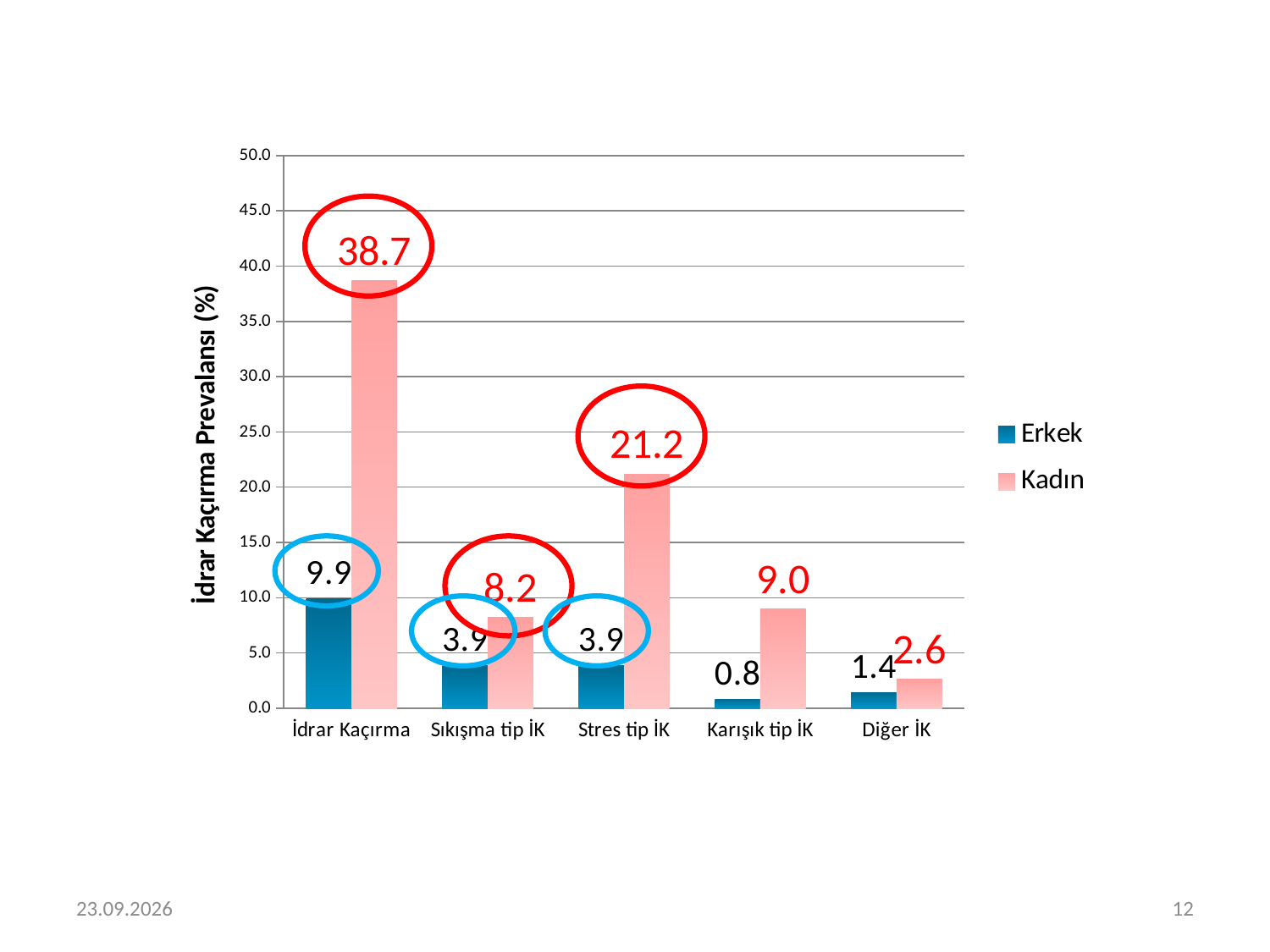
Which is larger for Sıkışma tip İK, the Erkek value or the Kadın value? Kadın Which category has the lowest Erkek value? Karışık tip İK What is the Kadın value for İdrar Kaçırma? 38.7 What is the Kadın value for Karışık tip İK? 9.0 What is the difference between the Kadın and Erkek values for Stres tip İK? 17.3 Is the Kadın value for Stres tip İK greater or less than 20.0? greater How many series does the legend list? 2 What is the Erkek value for Diğer İK? 1.4 How many categories are shown on the x axis? 5 What is the Erkek value for Stres tip İK? 3.9 What kind of chart is shown on the slide? bar chart Which category has the highest Kadın value? İdrar Kaçırma